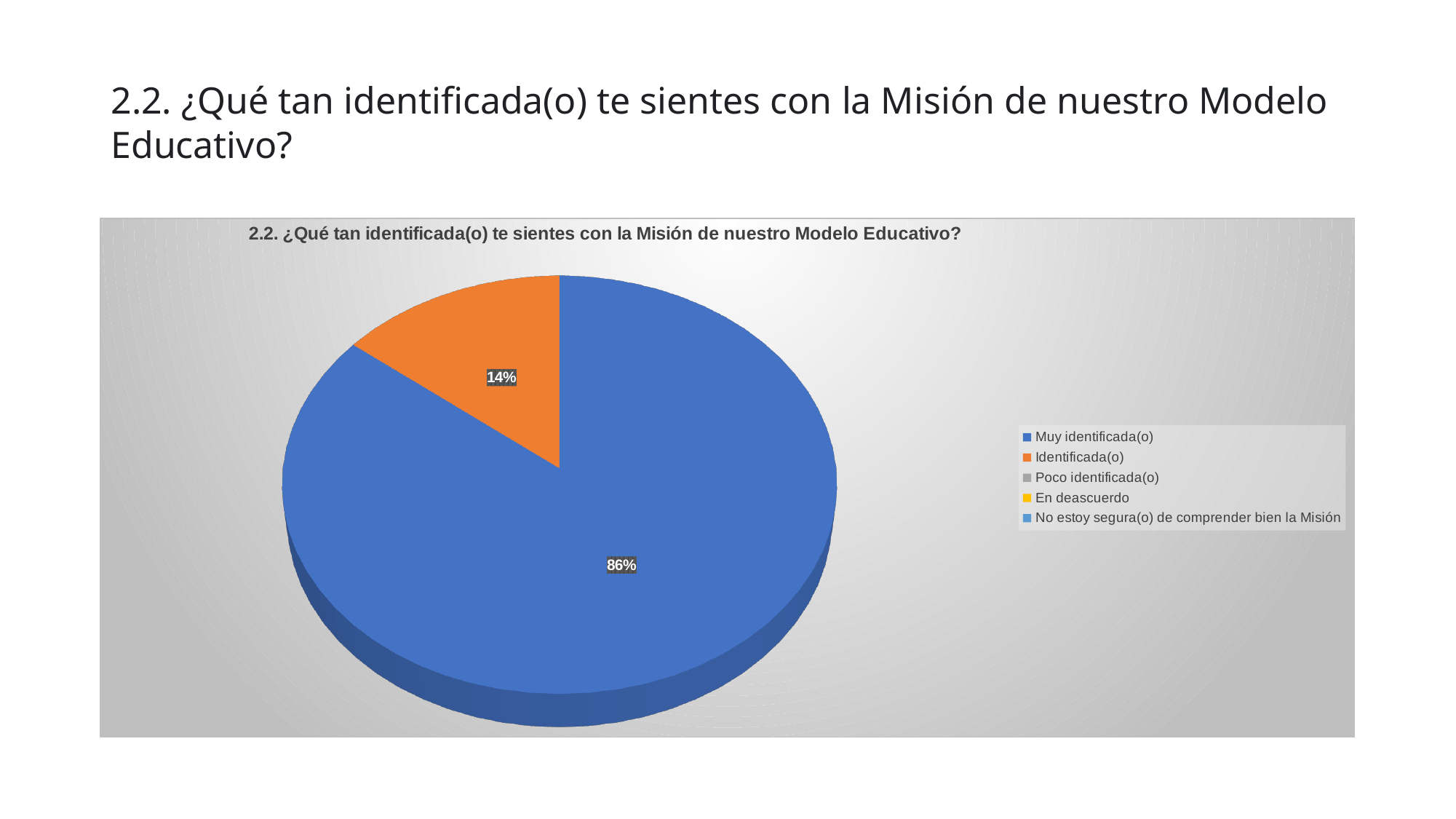
What kind of chart is shown on the slide? Pie chart Which is larger, the share for "Muy identificada(o)" or the share for "Identificada(o)"? Muy identificada(o) How many entries does the legend list? 5 What colour is the slice for "Identificada(o)"? Orange Which category has the largest slice of the pie? Muy identificada(o) Is the share for "Muy identificada(o)" greater or less than 50%? greater What is the difference between the "Muy identificada(o)" share and the "Identificada(o)" share? 72% What is the title of the chart? 2.2. ¿Qué tan identificada(o) te sientes con la Misión de nuestro Modelo Educativo? What share of the pie does "Muy identificada(o)" represent? 86% What share of the pie does "Identificada(o)" represent? 14% How many slices are visible in the pie? 2